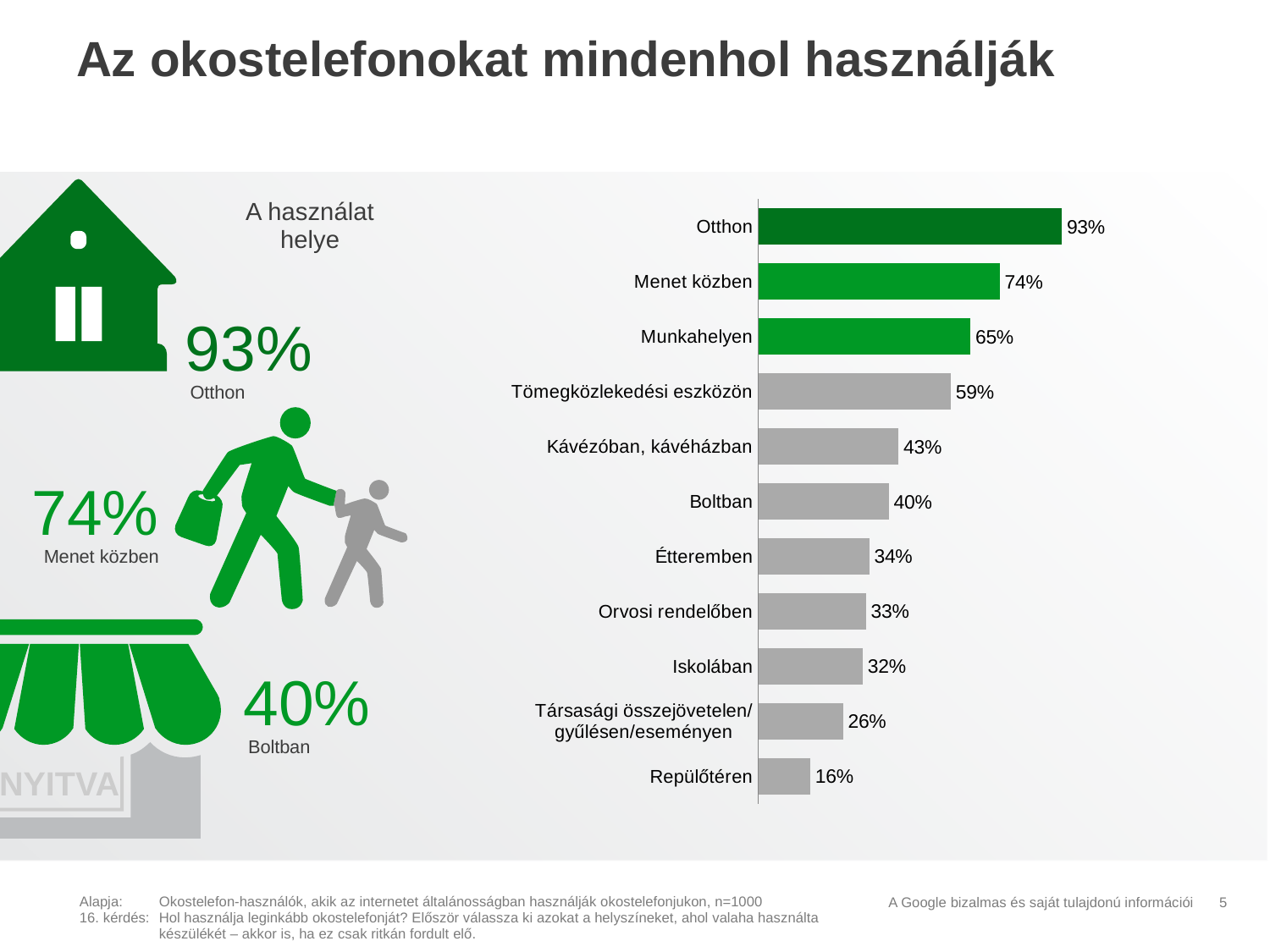
What is the value for Tömegközlekedési eszközön? 59% Which is larger, the value for Kávézóban, kávéházban or the value for Boltban? Kávézóban, kávéházban What is the value for Otthon? 93% What kind of chart is shown on the slide? Bar chart What is the difference between the values for Otthon and Menet közben? 19% What is the value for Társasági összejövetelen/gyűlésen/eseményen? 26% Which category has the lowest value? Repülőtéren What is the value for Repülőtéren? 16% How many categories are shown in the chart? 11 Which category has the highest value? Otthon What is the difference between the values for Munkahelyen and Iskolában? 33% How many bars in the chart are coloured green rather than grey? 3